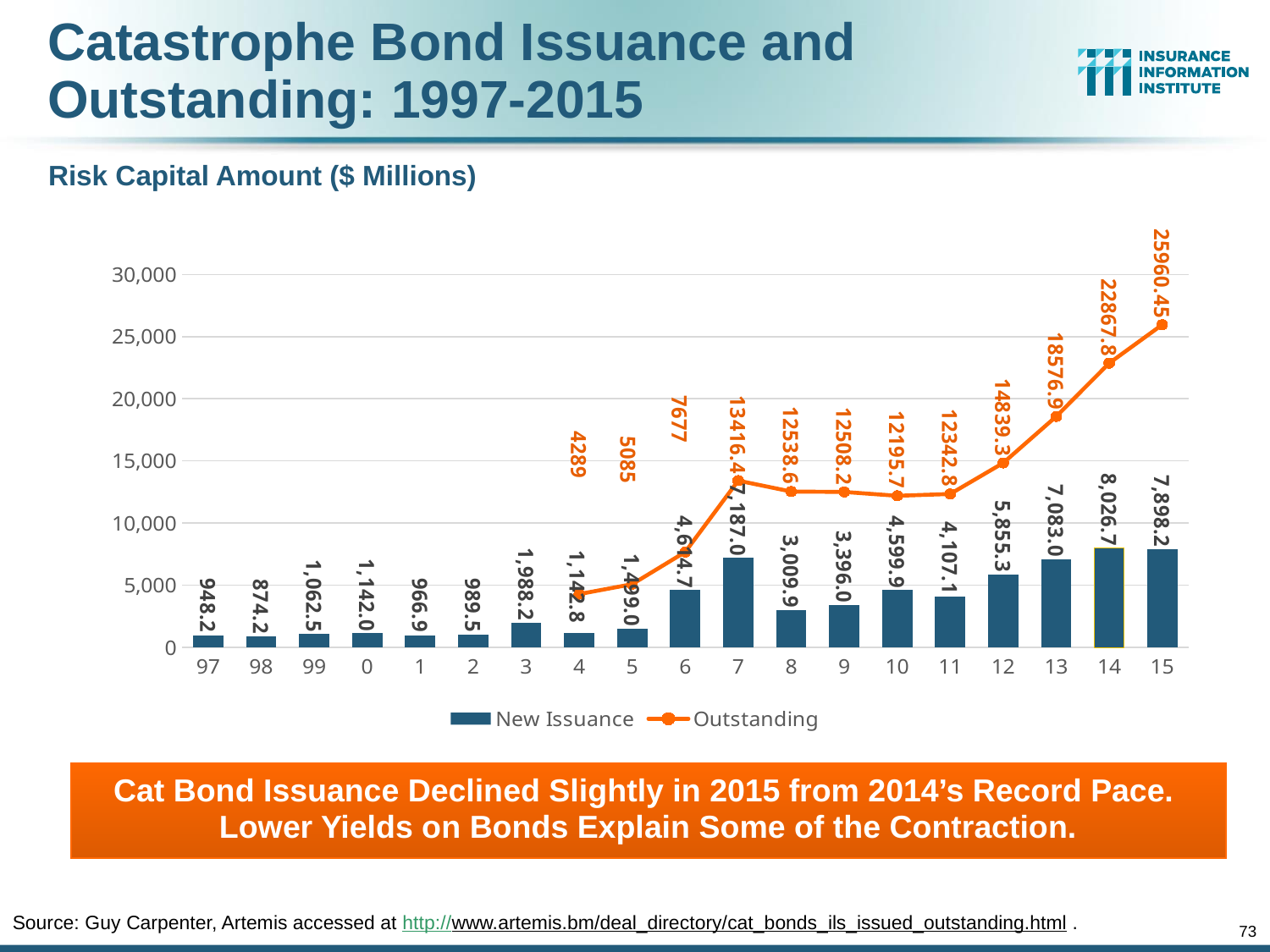
What is the difference between the Outstanding values for 15 and 14? 3092.65 What is the Outstanding value for 15? 25960.45 Which year has the highest New Issuance value? 14 What is the Outstanding value for 4? 4289 What kind of chart is this? Combination bar and line chart How many series does the legend list? 2 What is the New Issuance value for 14? 8,026.7 How many years are shown on the x axis? 19 Does the Outstanding line rise or fall from 12 to 15? Rise Which is larger, the New Issuance value for 7 or for 13? 7 Which year has the lowest New Issuance value? 98 What is the difference between the New Issuance values for 14 and 15? 128.5